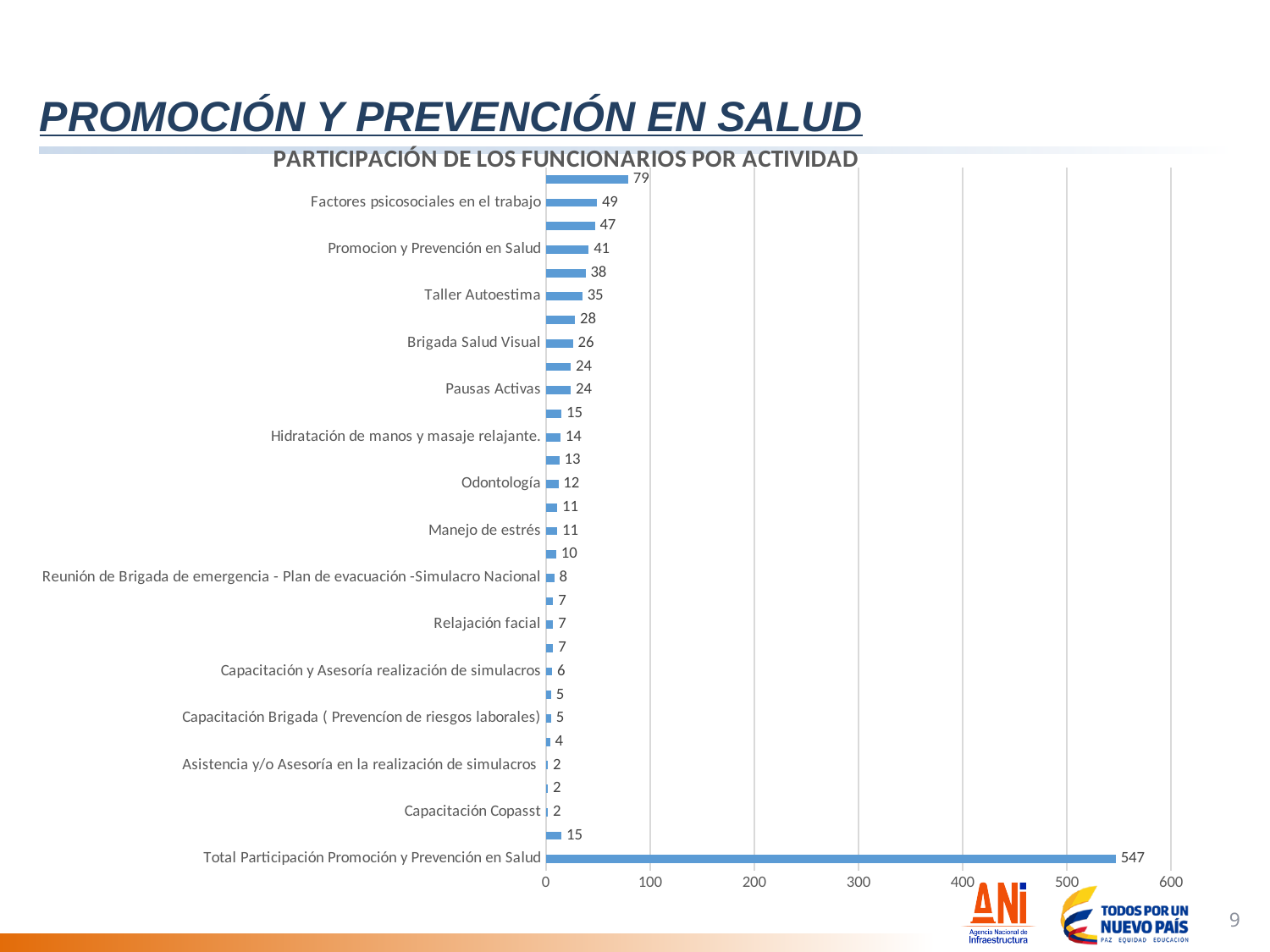
What is the value for Total Participación Promoción y Prevención en Salud? 547 What is the value for Capacitación Copasst? 2 Is the value for Total Participación Promoción y Prevención en Salud greater or less than 500? greater What is the value for Brigada Salud Visual? 26 What is the difference between the values for Hidratación de manos y masaje relajante. and Relajación facial? 7 Which category has the highest value in the chart? Total Participación Promoción y Prevención en Salud What is the value for Factores psicosociales en el trabajo? 49 What type of chart is shown on the slide? bar chart Which is larger, the value for Odontología or the value for Manejo de estrés? Odontología What is the title of the chart? PARTICIPACIÓN DE LOS FUNCIONARIOS POR ACTIVIDAD What is the difference between the values for Promocion y Prevención en Salud and Pausas Activas? 17 What is the value for Taller Autoestima? 35